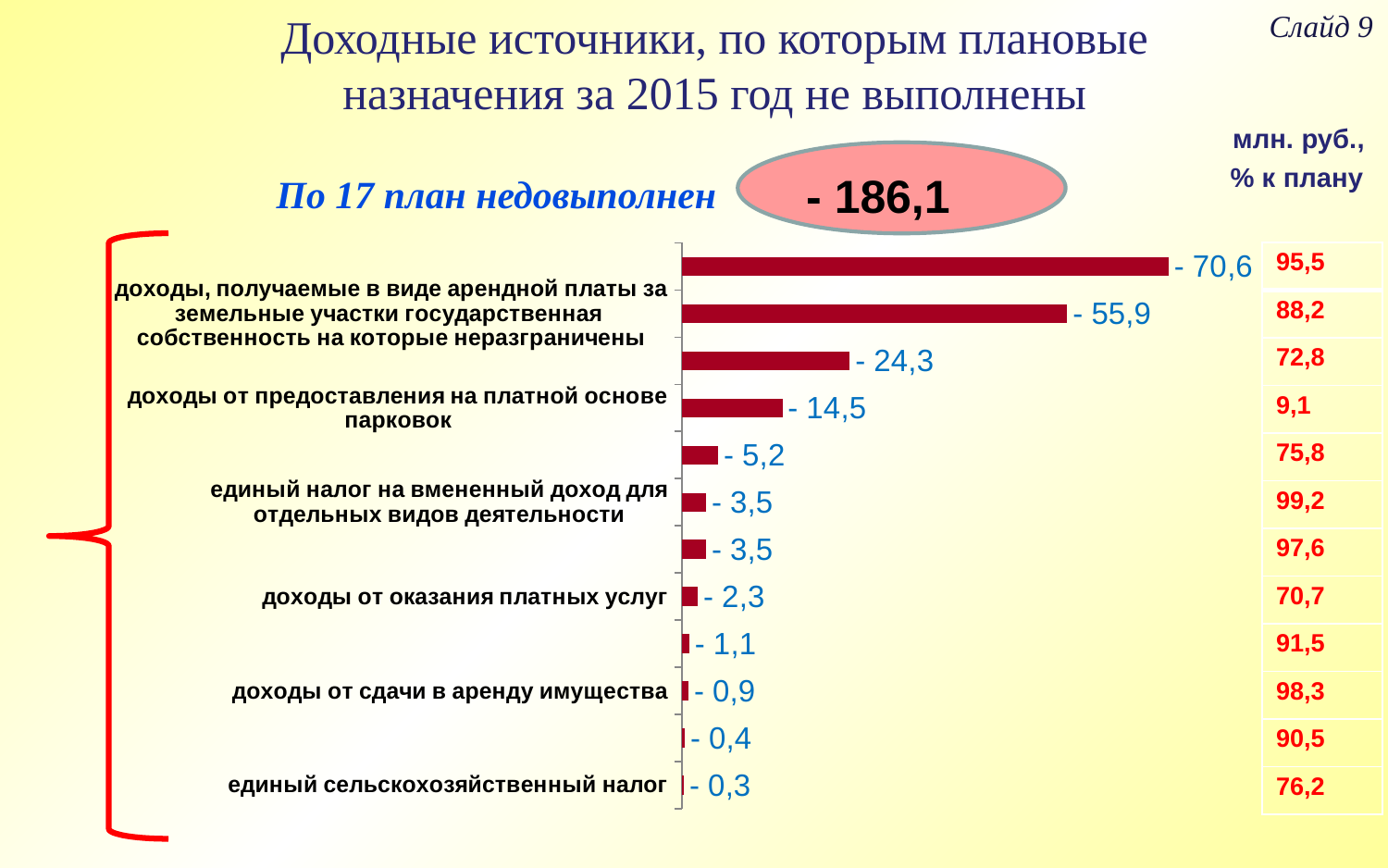
By how much does the shortfall for "доходы от предоставления на платной основе парковок" exceed that for "доходы от оказания платных услуг"? 12,2 What is the value shown for "доходы от оказания платных услуг"? - 2,3 What is the value labelled on the longest bar in the chart? - 70,6 How many bars are plotted in the chart? 12 What is the value shown for "доходы от предоставления на платной основе парковок"? - 14,5 What type of chart is shown on the slide? bar chart What total shortfall is shown in the oval above the chart? - 186,1 What is the value shown for "единый налог на вмененный доход для отдельных видов деятельности"? - 3,5 Which labelled category has the smallest shortfall: "единый сельскохозяйственный налог" or "доходы от сдачи в аренду имущества"? единый сельскохозяйственный налог What is the value shown for "доходы, получаемые в виде арендной платы за земельные участки государственная собственность на которые неразграничены"? - 55,9 What is the value shown for "единый сельскохозяйственный налог"? - 0,3 What is the value shown for "доходы от сдачи в аренду имущества"? - 0,9